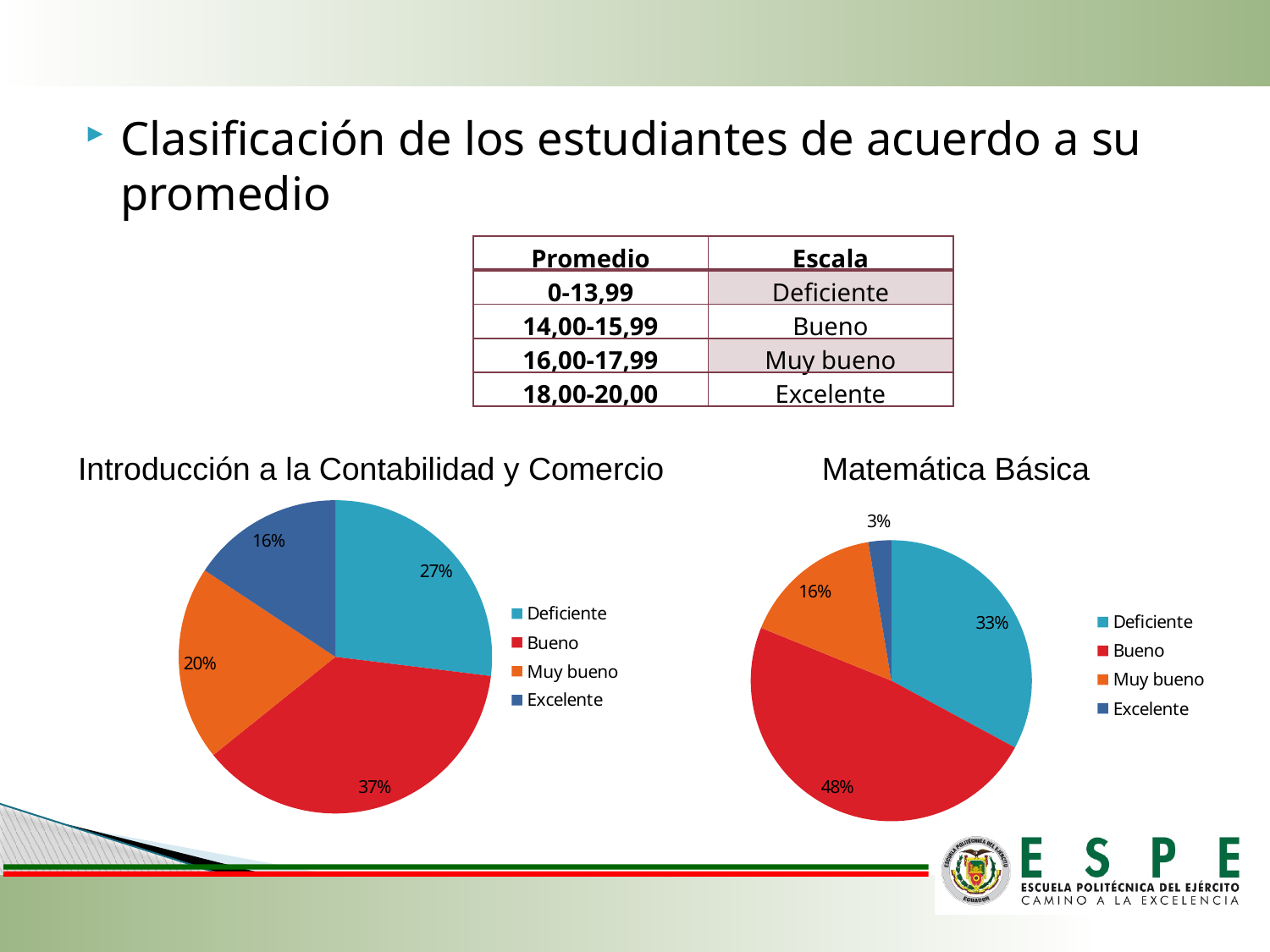
In the 'Matemática Básica' chart, which category has the smallest slice? Excelente How many categories does the 'Matemática Básica' chart show? 4 In the 'Introducción a la Contabilidad y Comercio' chart, what is the difference in percentage points between Bueno and Deficiente? 10 In the 'Matemática Básica' chart, what is the difference in percentage points between Bueno and Muy bueno? 32 In the 'Matemática Básica' chart, which category has the largest slice? Bueno In the 'Introducción a la Contabilidad y Comercio' chart, which category has the smallest slice? Excelente In the 'Introducción a la Contabilidad y Comercio' chart, what share of students are classified as Excelente? 16% What type of chart is used for 'Introducción a la Contabilidad y Comercio'? Pie chart In the 'Matemática Básica' chart, what share of students are classified as Excelente? 3% Which chart has the larger share of Deficiente students, 'Introducción a la Contabilidad y Comercio' or 'Matemática Básica'? Matemática Básica In the 'Matemática Básica' chart, what share of students are classified as Deficiente? 33% In the 'Introducción a la Contabilidad y Comercio' chart, what share of students are classified as Bueno? 37%